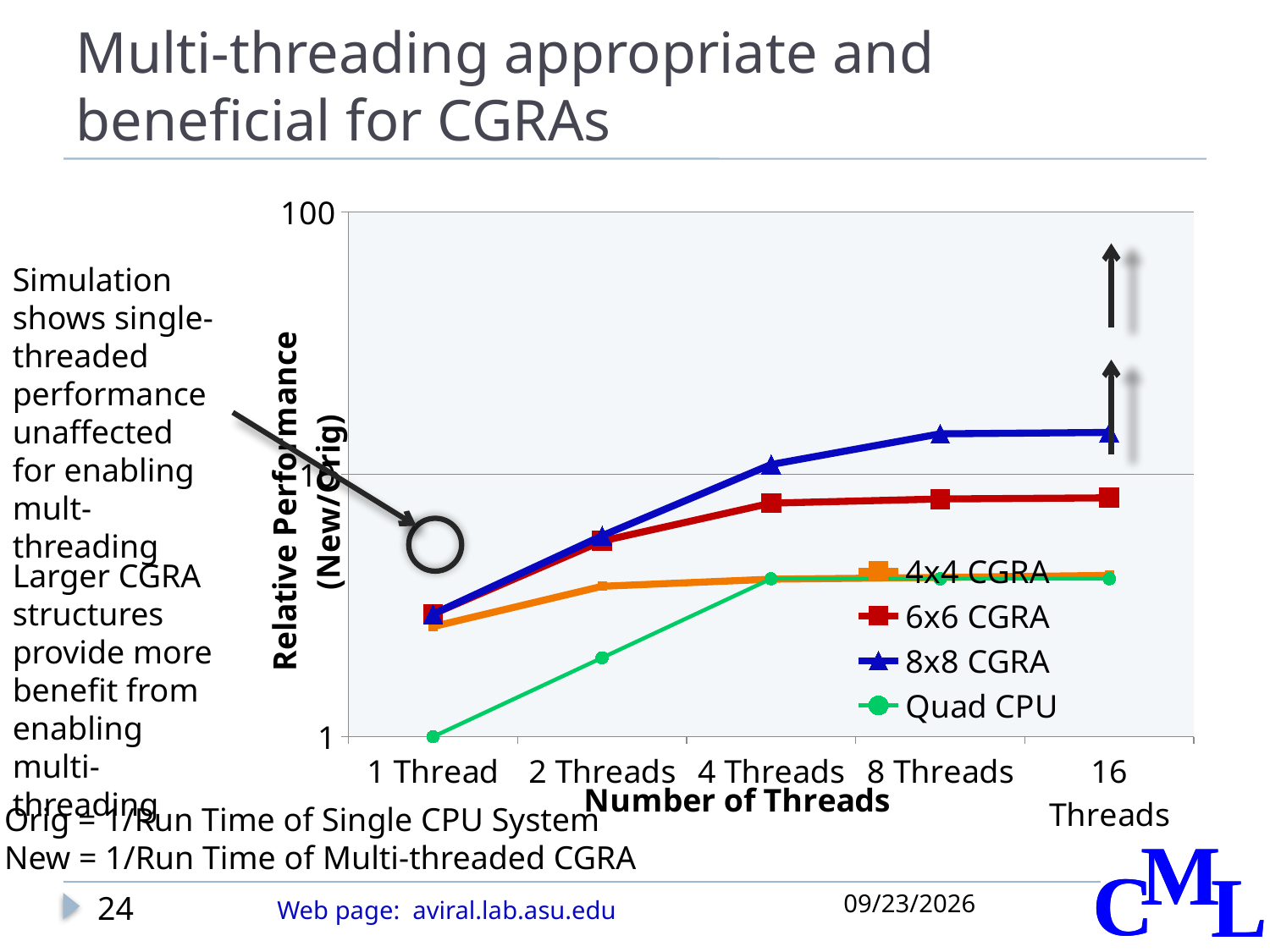
Which series has the highest value at 16 Threads? 8x8 CGRA Which series has the lowest value at 1 Thread? Quad CPU What is the value for Quad CPU at 1 Thread? 1 What kind of chart is shown on the slide? line chart What is the title of the y axis? Relative Performance (New/Orig) What is the title of the x axis? Number of Threads Does the 8x8 CGRA series rise or fall as the number of threads increases from 1 to 8? rise How many series does the chart legend list? 4 Is the value for 4x4 CGRA at 16 Threads greater or less than 10? less Is the value for 8x8 CGRA at 8 Threads greater or less than 10? greater How many thread-count categories are shown on the x axis? 5 At 8 Threads, which is larger: 6x6 CGRA or 4x4 CGRA? 6x6 CGRA